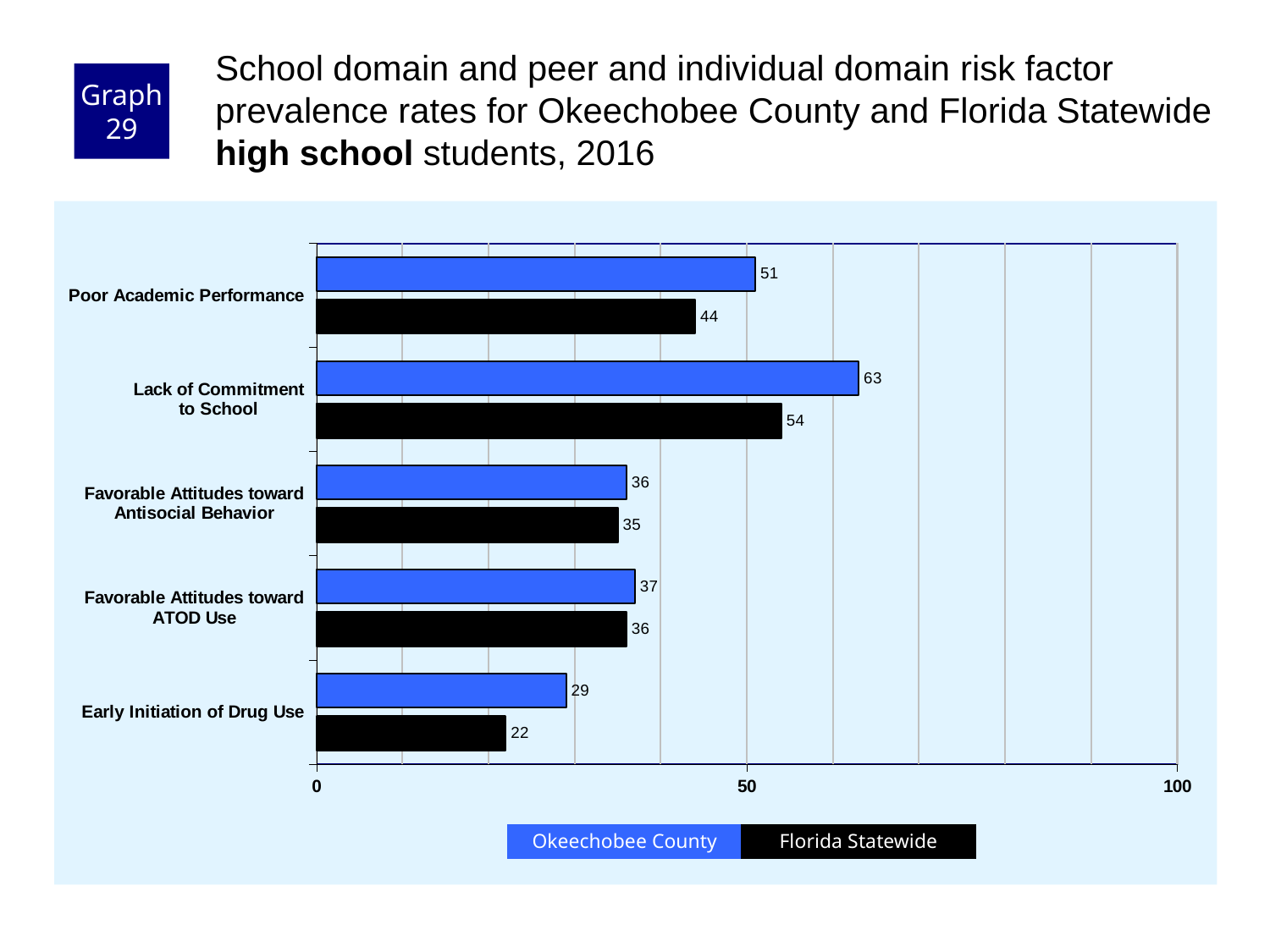
Which risk factor has the lowest Florida Statewide value? Early Initiation of Drug Use What is the difference between the Okeechobee County and Florida Statewide values for Lack of Commitment to School? 9 How many risk factor categories are shown on the chart? 5 What is the Florida Statewide value for Early Initiation of Drug Use? 22 What is the Okeechobee County value for Lack of Commitment to School? 63 Is the Okeechobee County value for Poor Academic Performance greater or less than 50? greater What kind of chart is shown on the slide? Bar chart What is the Florida Statewide value for Poor Academic Performance? 44 What is the difference between the Okeechobee County and Florida Statewide values for Poor Academic Performance? 7 How many series does the legend list? 2 Which risk factor has the highest Okeechobee County value? Lack of Commitment to School Which is larger for Early Initiation of Drug Use: the Okeechobee County value or the Florida Statewide value? Okeechobee County